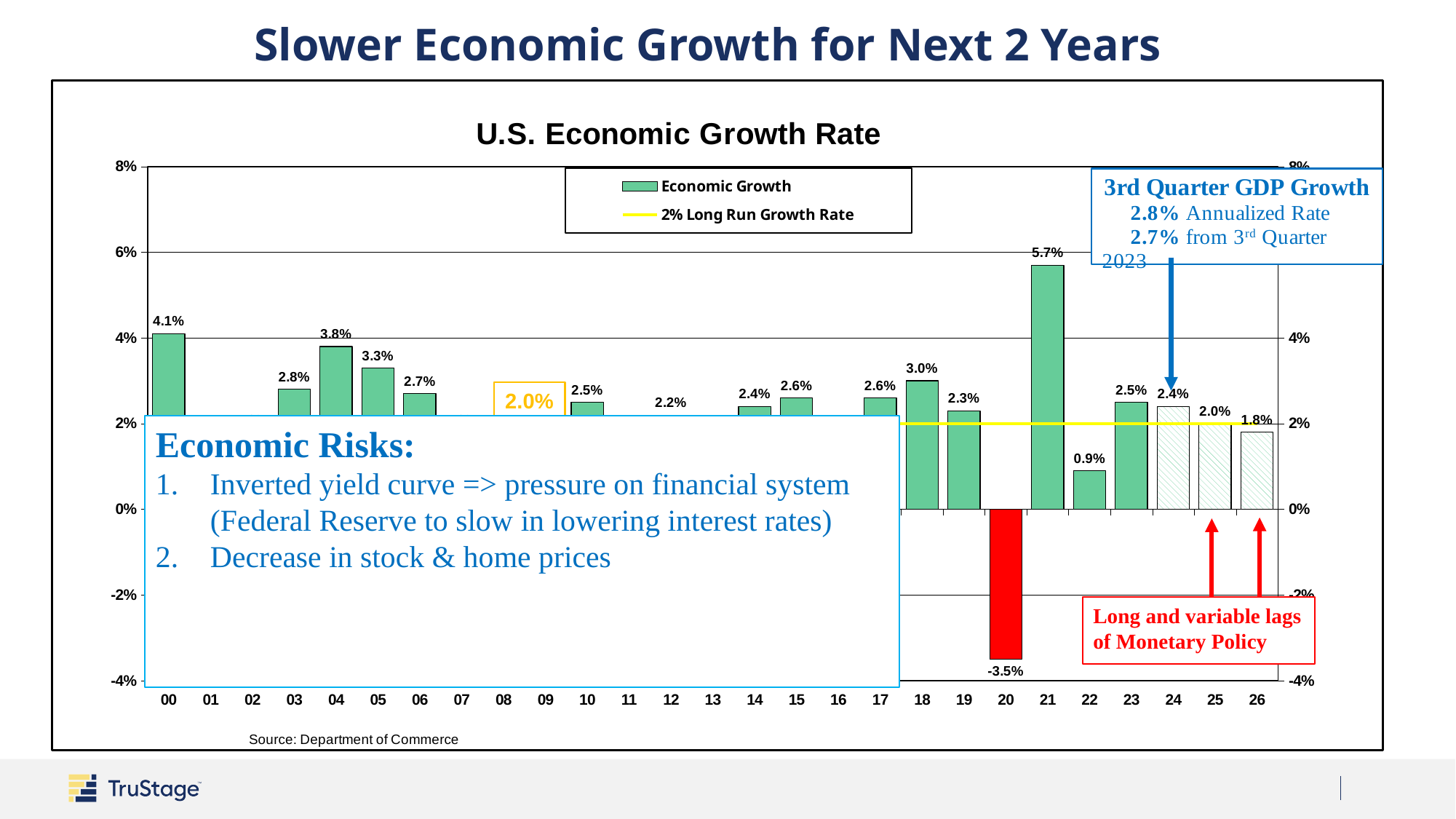
What is the title of the chart? U.S. Economic Growth Rate What is the economic growth rate shown for 21? 5.7% What is the economic growth rate shown for 00? 4.1% What is the difference between the growth rates for 21 and 22? 4.8 percentage points What is the economic growth rate shown for 26? 1.8% What kind of chart is shown on the slide? Combination bar and line chart How many series does the chart legend list? 2 Which year has the lowest economic growth rate in the chart? 20 What is the economic growth rate shown for 22? 0.9% Do the growth rates rise or fall from 24 to 26? Fall Which year has the highest economic growth rate in the chart? 21 Which year has the higher growth rate, 04 or 05? 04